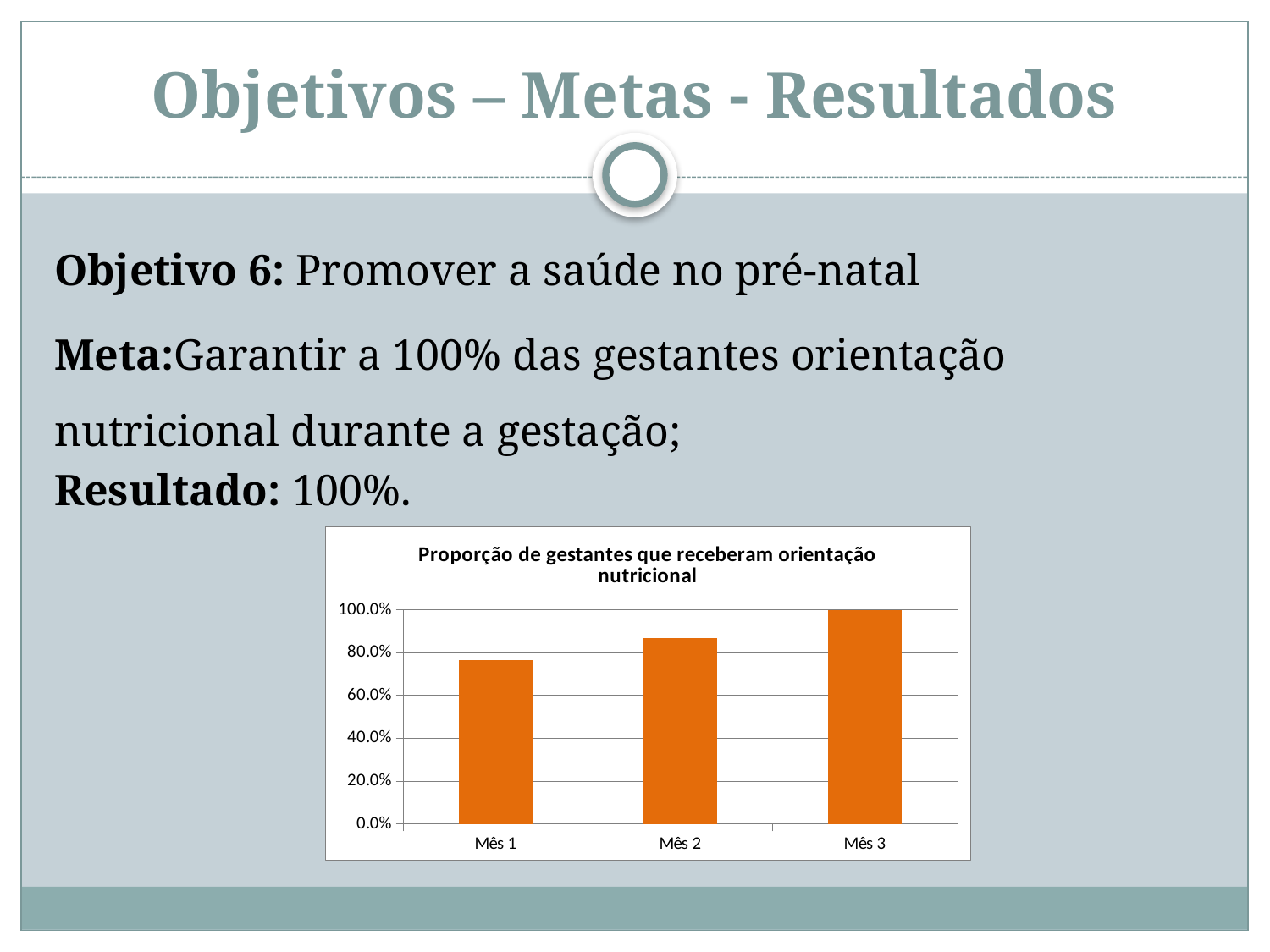
Is the value for Mês 2 greater or less than 100.0%? less What is the value for Mês 3 on the chart? 100.0% What colour are the bars in the chart? orange Which is larger, the value for Mês 1 or the value for Mês 2? Mês 2 Is the value for Mês 1 greater or less than 60.0%? greater How many categories (months) are plotted on the chart? 3 Which month has the highest proportion of pregnant women who received nutritional guidance? Mês 3 Which month has the lowest proportion of pregnant women who received nutritional guidance? Mês 1 Is the value for Mês 2 greater or less than 80.0%? greater What is the title of the chart? Proporção de gestantes que receberam orientação nutricional What kind of chart is shown on the slide? bar chart Do the values rise or fall from Mês 1 to Mês 3? rise